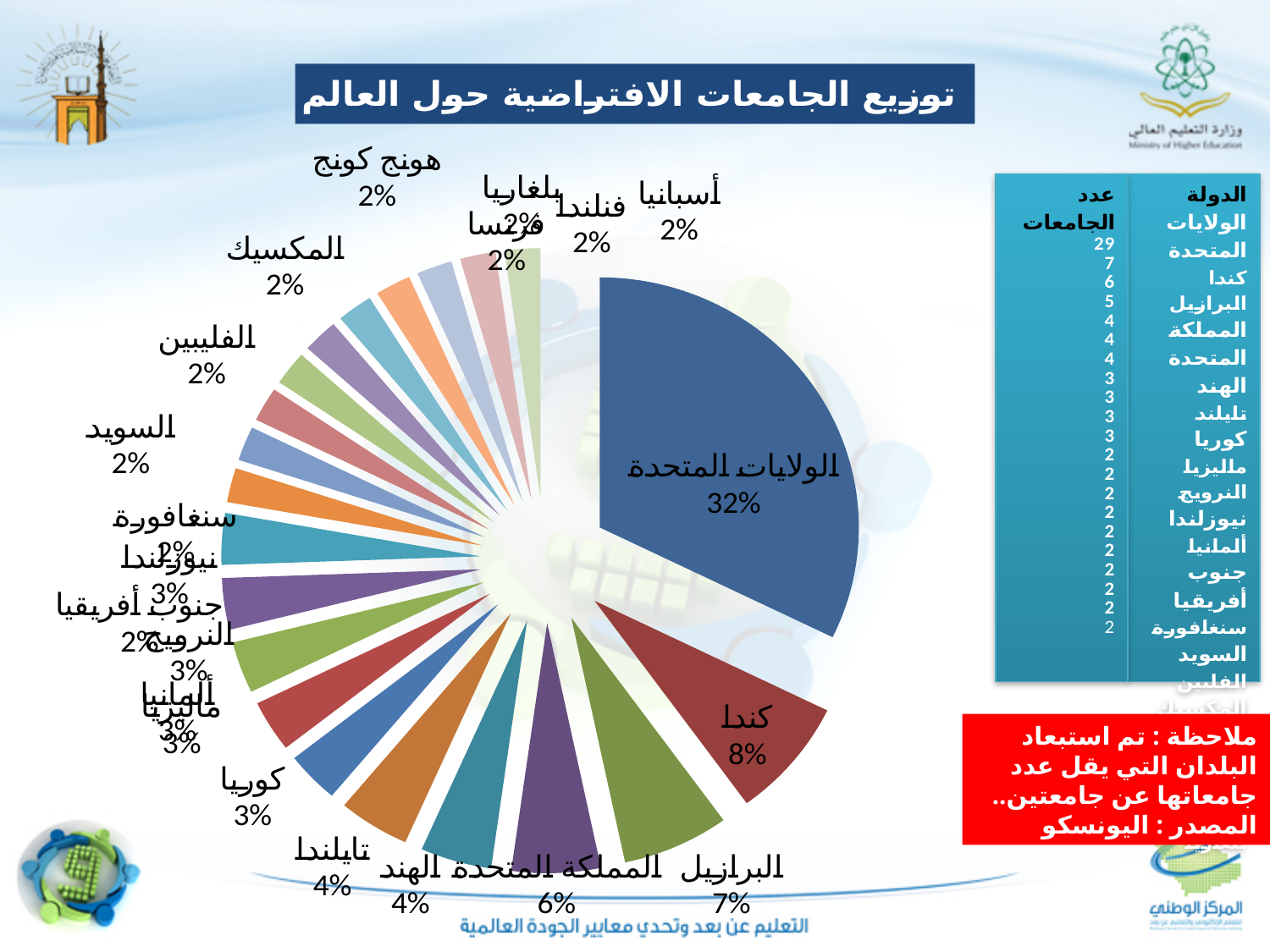
What kind of chart is shown on the slide? pie chart What share of the pie does الولايات المتحدة hold? 32% Which country has the largest slice of the pie? الولايات المتحدة What percentage is shown for كندا? 8% What is the title of the chart? توزيع الجامعات الافتراضية حول العالم What percentage is shown for هونج كونج? 2% Which has a larger share, كندا or البرازيل? كندا What percentage is shown for كوريا? 3% By how many percentage points does الولايات المتحدة exceed كندا? 24 What percentage is shown for تايلند? 4% What percentage is shown for البرازيل? 7% What percentage is shown for المملكة المتحدة? 6%